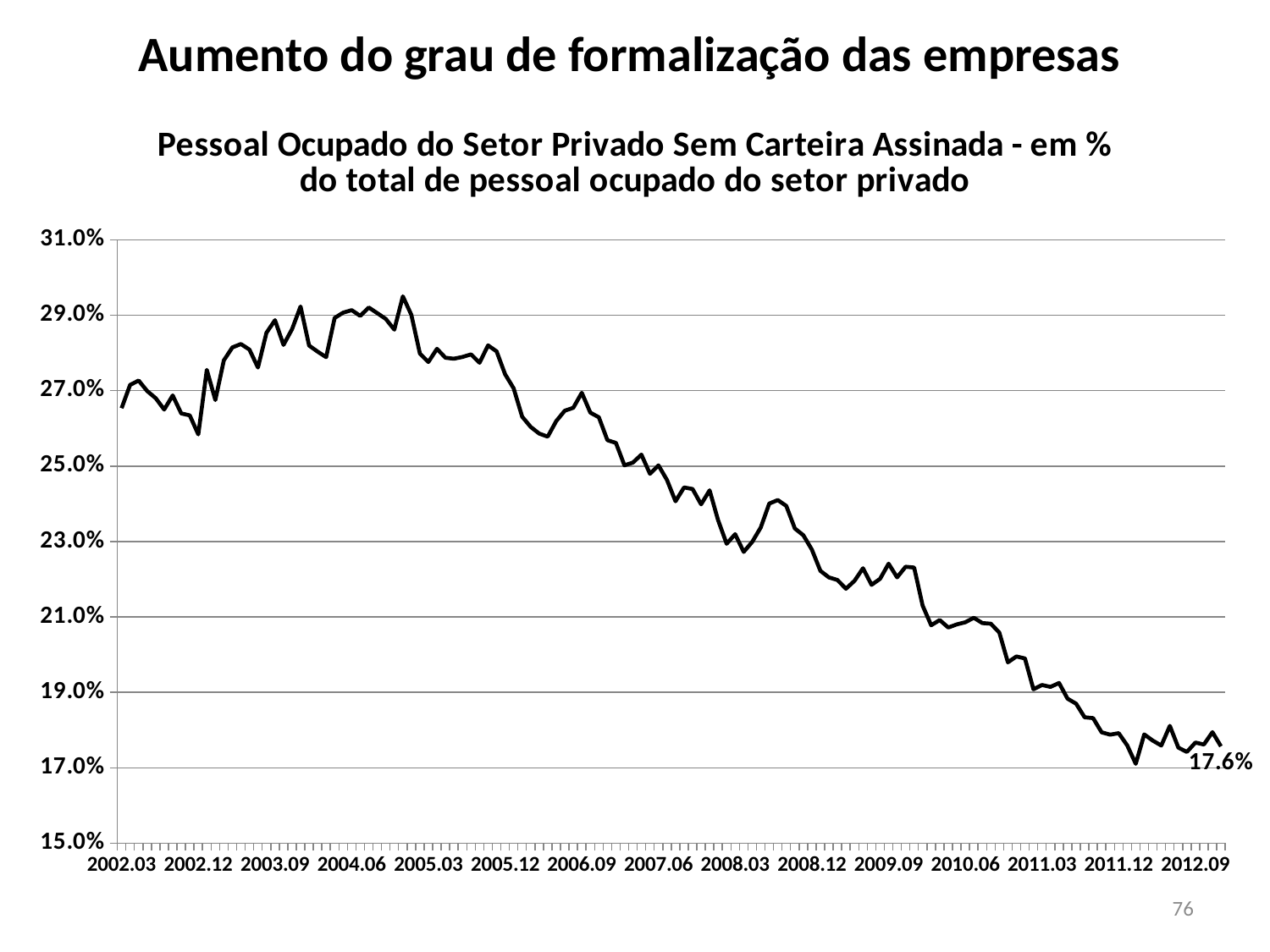
What kind of chart is shown on the slide? line chart Is the value at 2010.06 greater or less than 23.0%? less Which is larger, the value at 2002.03 or the value at 2012.09? 2002.03 What is the title of the chart? Pessoal Ocupado do Setor Privado Sem Carteira Assinada - em % do total de pessoal ocupado do setor privado Is the highest point on the line greater or less than 29.0%? greater Is the value at 2005.03 greater or less than 27.0%? greater What value is printed as the data label at the end of the line? 17.6% What is the highest value shown on the vertical axis? 31.0% Overall, do the values rise or fall from 2002.03 to 2012.09? fall